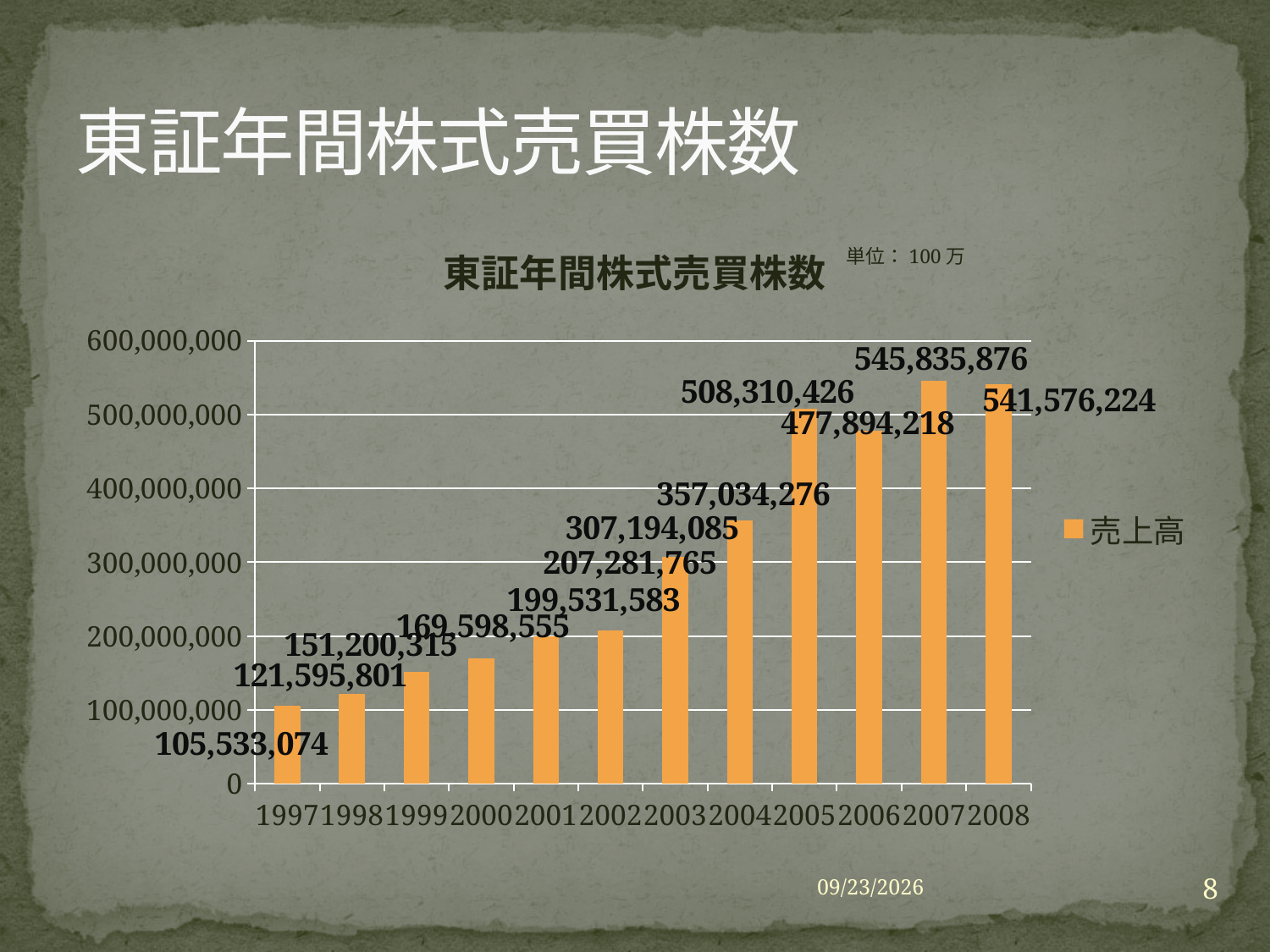
What kind of chart is this? bar chart What series name does the legend show? 売上高 Which is larger, the value for 2005 or the value for 2006? 2005 Which year has the lowest value? 1997 What is the value for 2008? 541,576,224 How many years are shown on the x axis? 12 What is the value for 2005? 508,310,426 What is the difference between the values for 2005 and 2006? 30,416,208 Which year has the highest value? 2007 What is the value for 1997? 105,533,074 What is the difference between the values for 1998 and 1997? 16,062,727 Is the value for 2004 greater or less than 300,000,000? greater